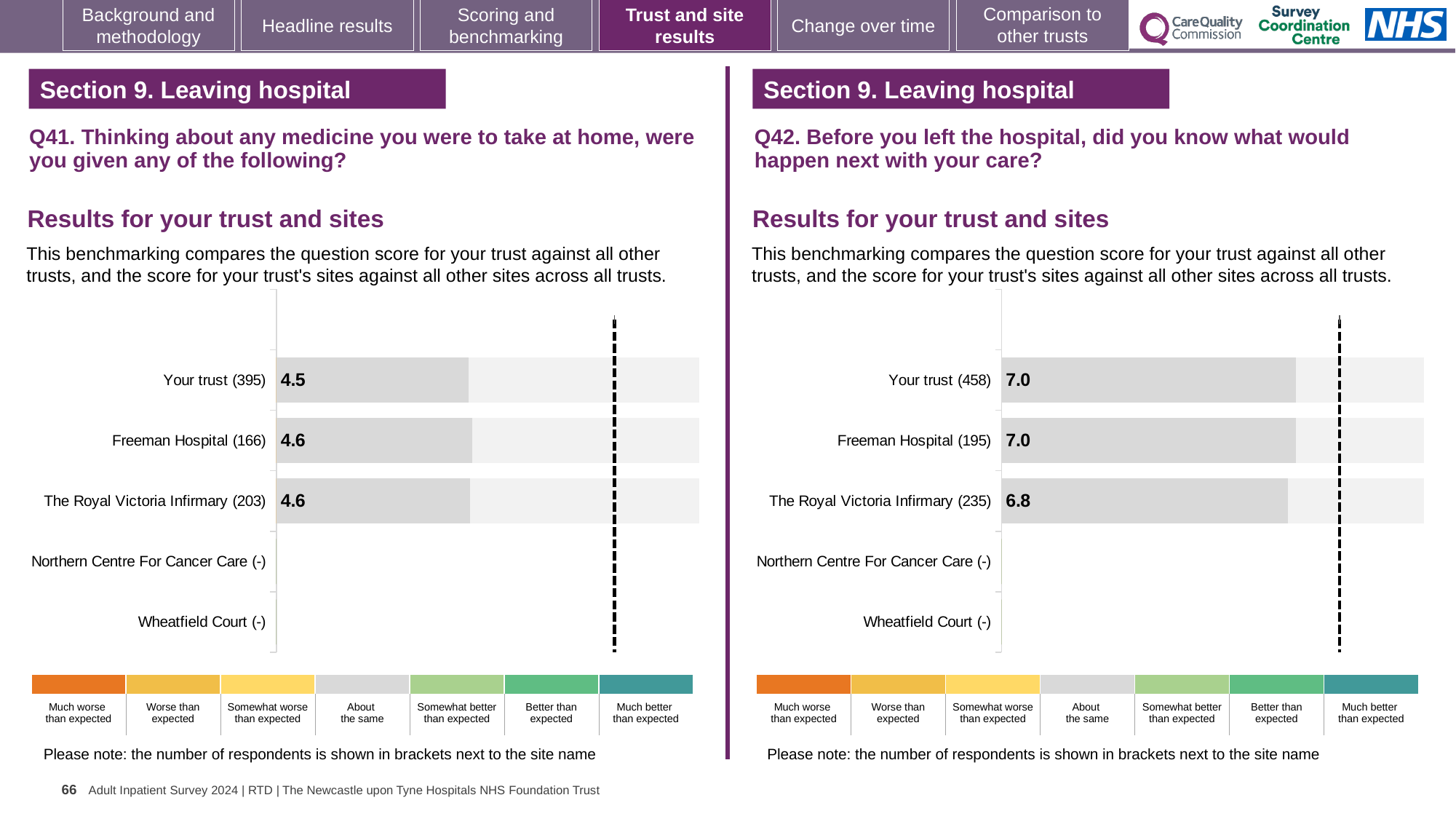
In the Q41 chart on the left, what is the score for Your trust? 4.5 In the Q41 chart on the left, how many respondents are shown in brackets for Freeman Hospital? 166 How many site rows (excluding Your trust) are listed in the Q42 chart on the right? 4 In the Q42 chart on the right, what is the score for Your trust? 7.0 In the Q42 chart on the right, which of the three scored rows has the lowest score? The Royal Victoria Infirmary In the Q42 chart on the right, what is the score for The Royal Victoria Infirmary? 6.8 In the Q42 chart on the right, what is the difference between the score for Freeman Hospital and the score for The Royal Victoria Infirmary? 0.2 What kind of chart is used in the Q41 chart on the left? bar chart In the Q41 chart on the left, which of the three scored rows has the lowest score? Your trust In the Q41 chart on the left, is the score for The Royal Victoria Infirmary higher or lower than the score for Your trust? higher In the Q41 chart on the left, what is the score for Freeman Hospital? 4.6 In the Q42 chart on the right, how many respondents are shown in brackets for Your trust? 458